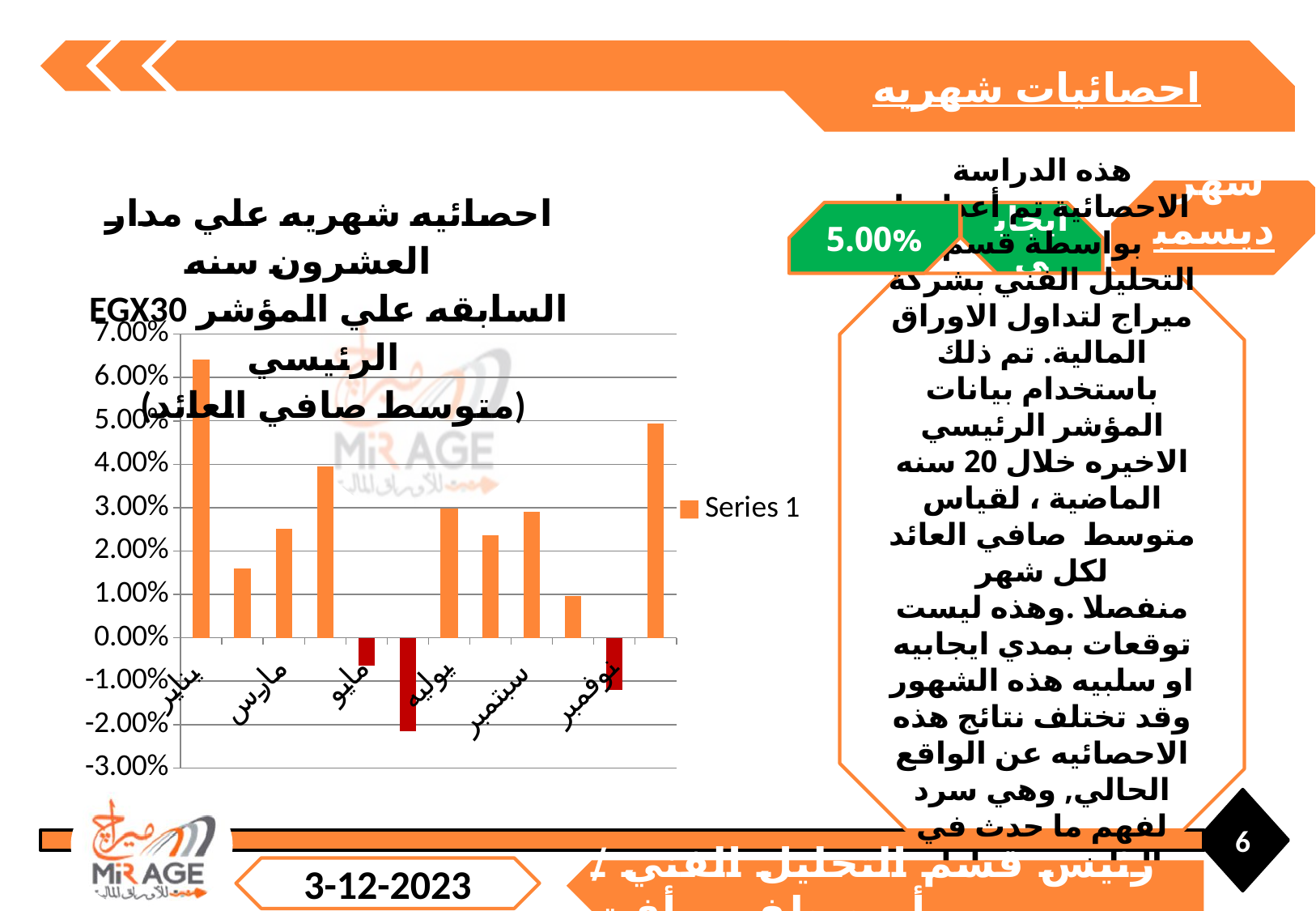
Is the value for يوليه greater or less than 2.00%? greater Is the value for مايو greater or less than 0.00%? less Which labeled month has the highest value in the chart? يناير What kind of chart is shown on the slide? bar chart Which is larger, the value for يناير or the value for مارس? يناير What is the name of the series shown in the chart legend? Series 1 Is the value for نوفمبر greater or less than 0.00%? less How many series does the chart legend list? 1 How many bars are plotted in the chart? 12 Which is larger, the value for سبتمبر or the value for نوفمبر? سبتمبر